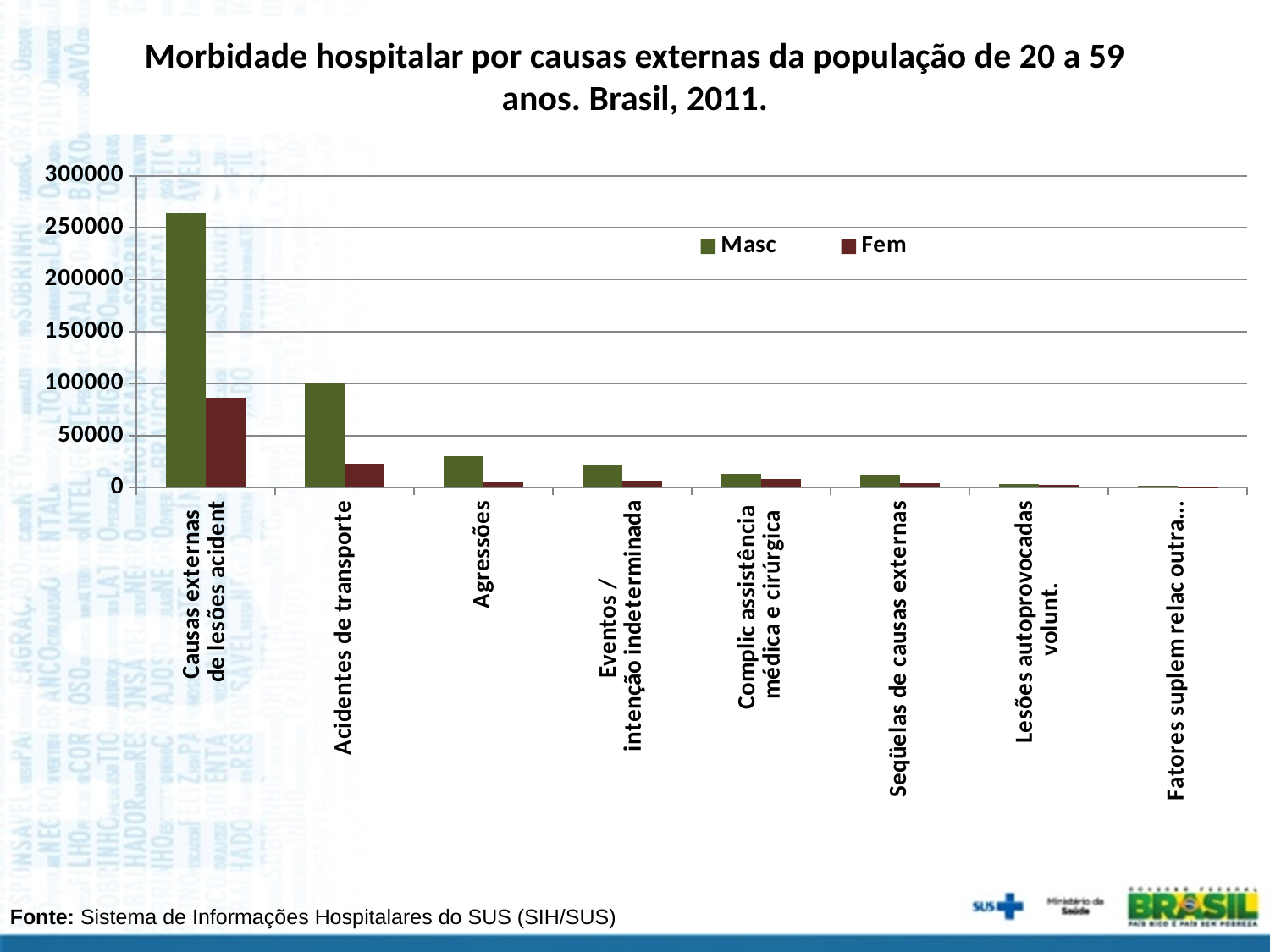
For Causas externas de lesões acident, which series has the larger value, Masc or Fem? Masc How many categories are shown on the x axis? 8 Is the Fem value for Acidentes de transporte greater or less than 50000? less Is the Masc value for Agressões greater or less than 50000? less Is the Fem value for Causas externas de lesões acident greater or less than 100000? less Which category has the highest Fem value? Causas externas de lesões acident Which is larger: the Masc value for Acidentes de transporte or the Masc value for Agressões? Acidentes de transporte What kind of chart is shown on the slide? Bar chart Which category has the highest Masc value? Causas externas de lesões acident How many series does the legend list? 2 Do the Masc values rise or fall moving from left to right along the x axis? Fall